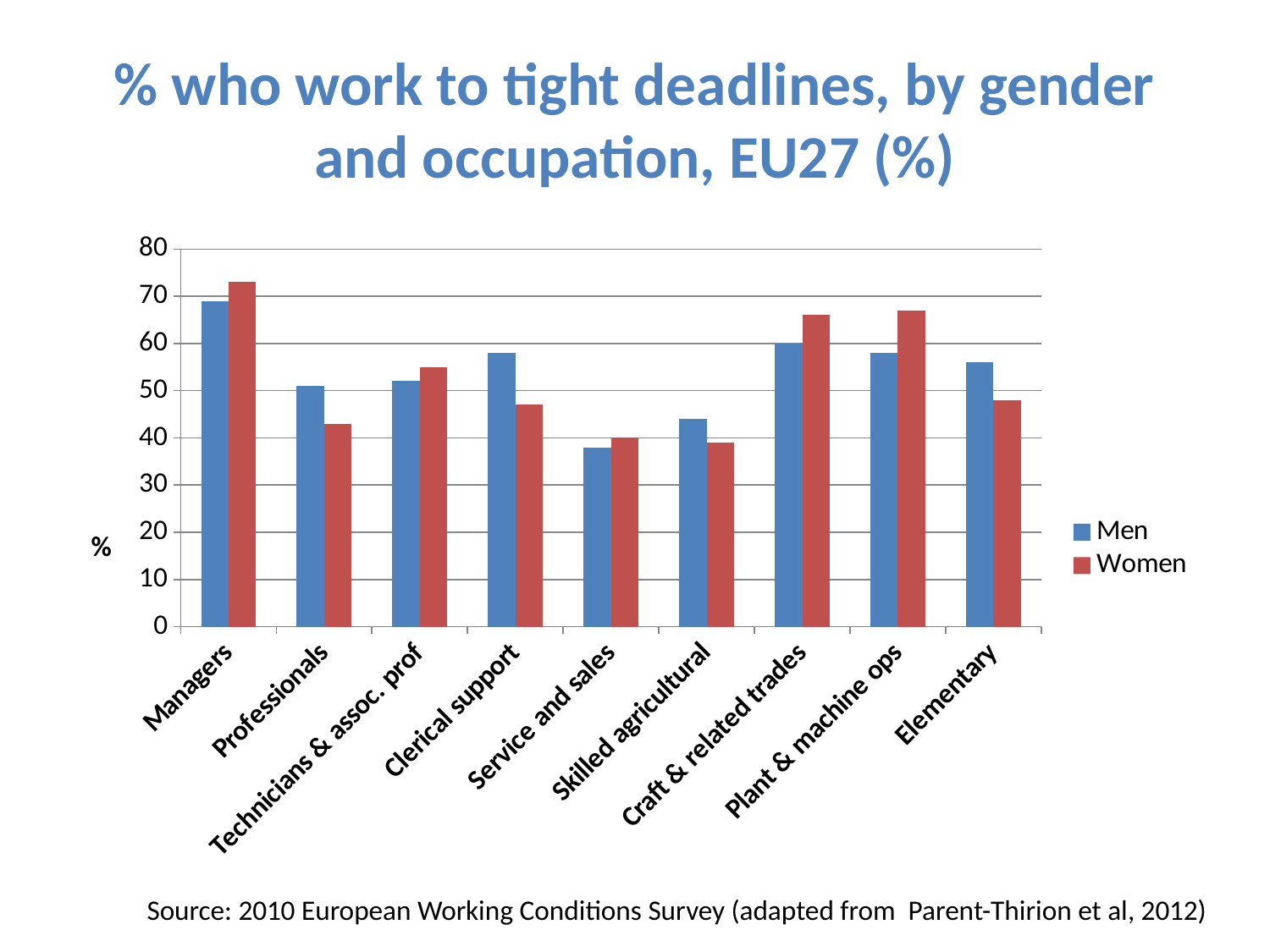
For Plant & machine ops, which is larger, the value for Men or for Women? Women Is the value for Men in Service and sales greater or less than 40? less Is the value for Women in Craft & related trades greater or less than 60? greater Which occupation has the lowest value for Men? Service and sales What kind of chart is shown on the slide? bar chart Which occupation has the highest value for Men? Managers How many occupation categories are shown on the x axis? 9 Which occupation has the highest value for Women? Managers Is the value for Women in Managers greater or less than 70? greater Which series is shown in red in the legend? Women For Professionals, which is larger, the value for Men or for Women? Men How many series does the legend list? 2